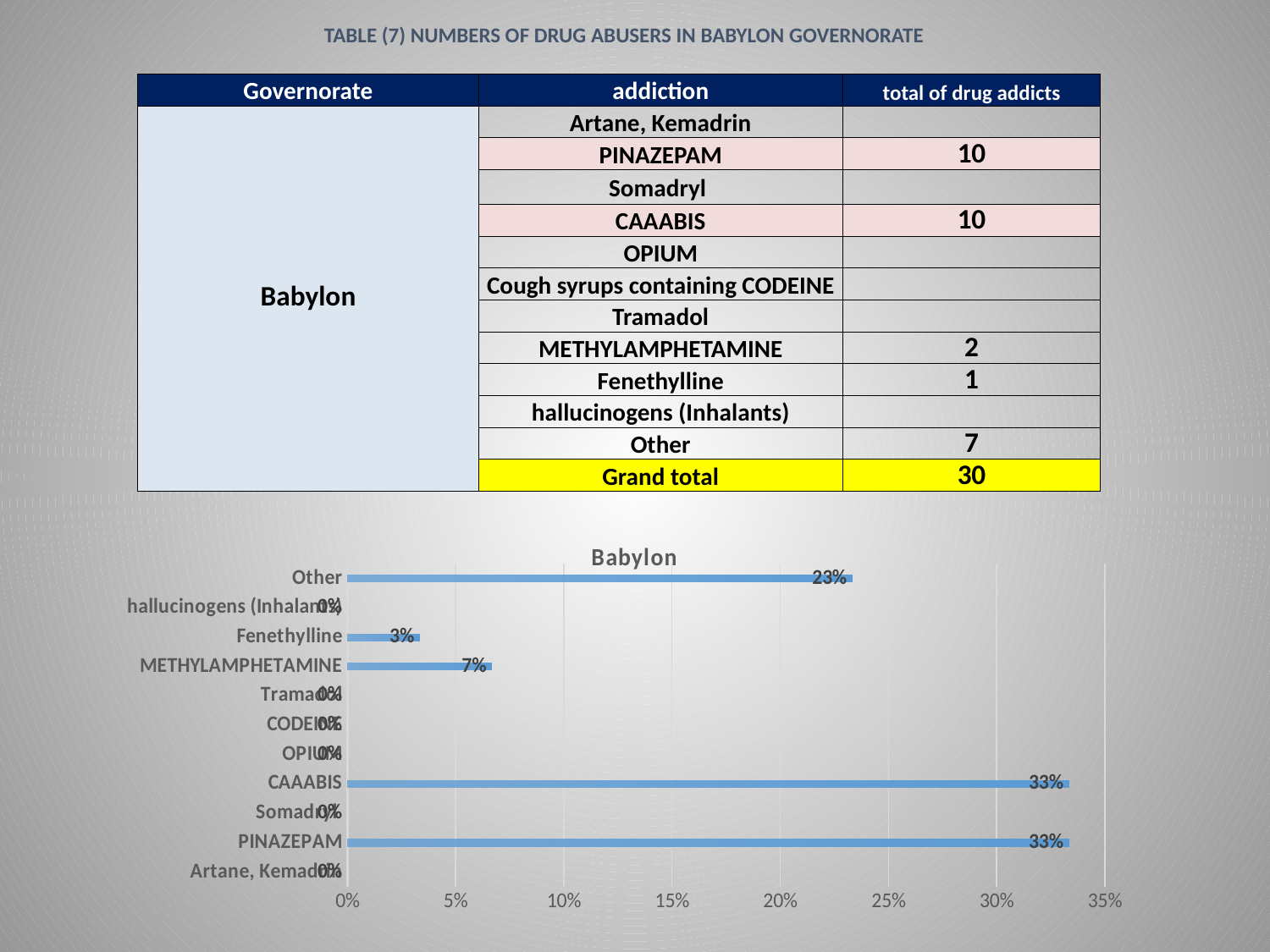
Is the value for Other in the Babylon chart greater or less than 20%? greater What is the value for OPIUM in the Babylon chart? 0% How many categories are shown in the Babylon chart? 11 What is the value for PINAZEPAM in the Babylon chart? 33% What kind of chart is shown on the slide? bar chart What is the value for Fenethylline in the Babylon chart? 3% What is the value for Other in the Babylon chart? 23% Which is larger in the Babylon chart, the value for Other or the value for Fenethylline? Other What is the value for CAAABIS in the Babylon chart? 33% What is the value for METHYLAMPHETAMINE in the Babylon chart? 7% What is the difference between the values for Other and METHYLAMPHETAMINE in the Babylon chart? 16% What is the title of the chart on the slide? Babylon